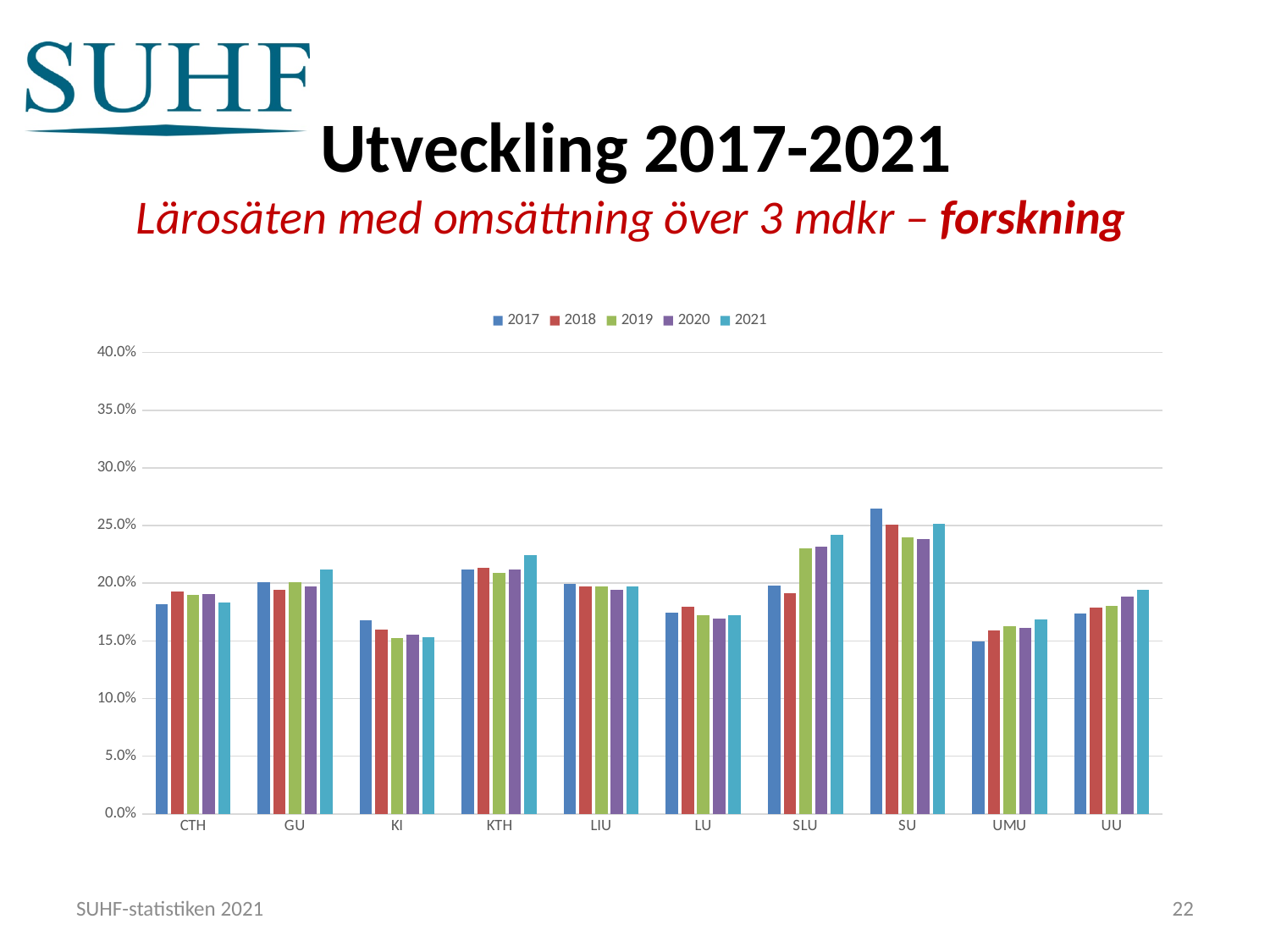
What kind of chart is shown on the slide? bar chart Is the value for KI in 2021 greater or less than 20.0%? less How many universities (categories) are shown on the x axis? 10 Which university has the lowest value for 2021? KI Which is larger: the 2021 value for SLU or the 2021 value for LU? SLU For SU, which year has the highest value? 2017 Is the value for SU in 2017 greater or less than 25.0%? greater For UMU, which year has the lowest value? 2017 Which university has the tallest bar in the chart? SU Which years are listed in the legend? 2017, 2018, 2019, 2020, 2021 How many series does the legend list? 5 For UU, do the values rise or fall from 2017 to 2021? rise